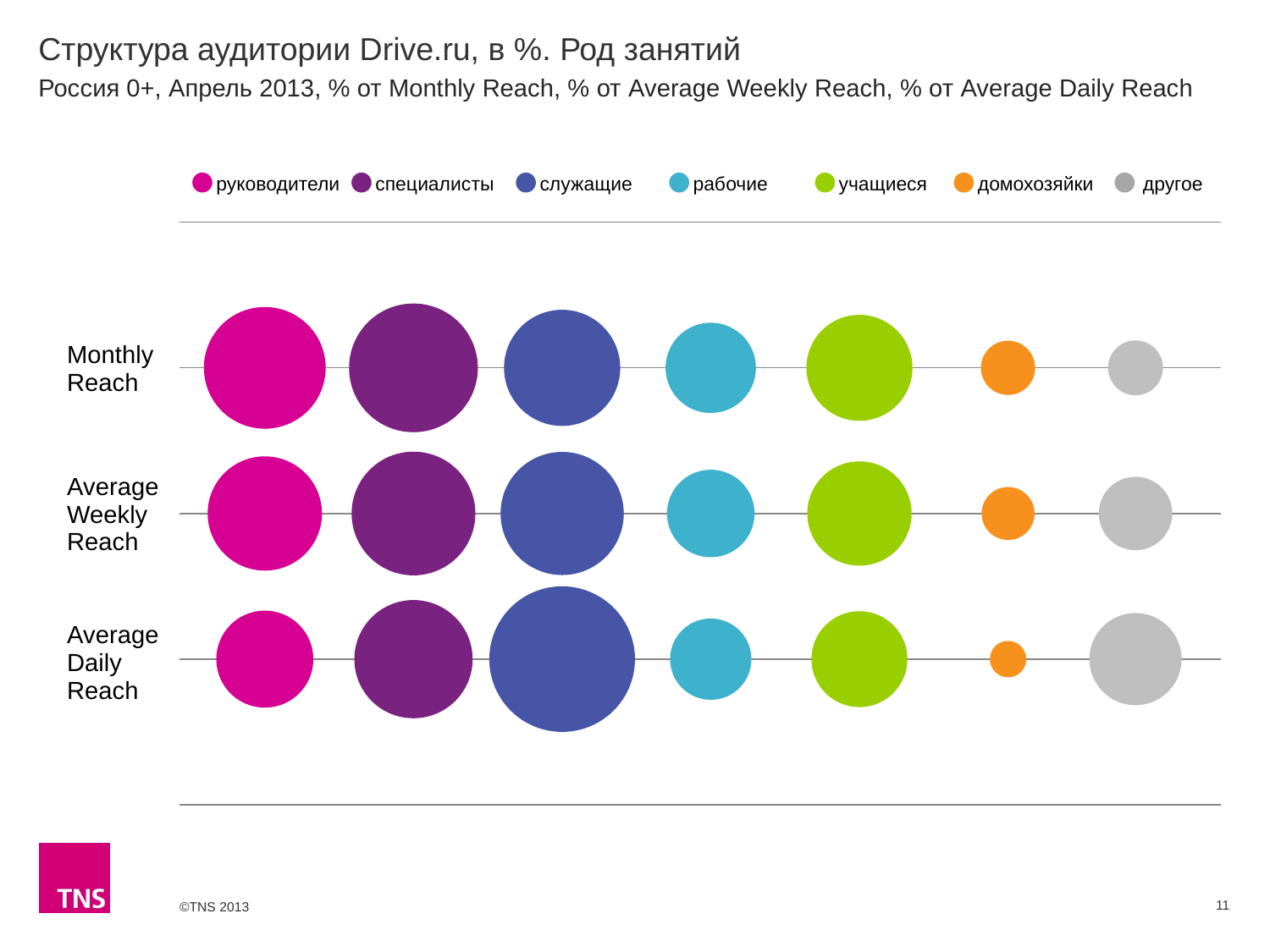
How many series does the legend list? 7 What kind of chart is shown on the slide? Bubble chart Which colour represents учащиеся in the legend? Green In the Average Daily Reach row, which bubble is larger: другое or домохозяйки? другое Does the bubble for служащие grow or shrink going from Monthly Reach to Average Daily Reach? Grows In the Monthly Reach row, which bubble is larger: руководители or домохозяйки? руководители How many reach categories (rows) are plotted on the chart? 3 In the Average Daily Reach row, which occupation group has the largest bubble? служащие Does the bubble for домохозяйки grow or shrink going from Monthly Reach to Average Daily Reach? Shrinks In the Average Weekly Reach row, which occupation group has the smallest bubble? домохозяйки In the Average Daily Reach row, which occupation group has the smallest bubble? домохозяйки In the Average Daily Reach row, which bubble is larger: служащие or рабочие? служащие